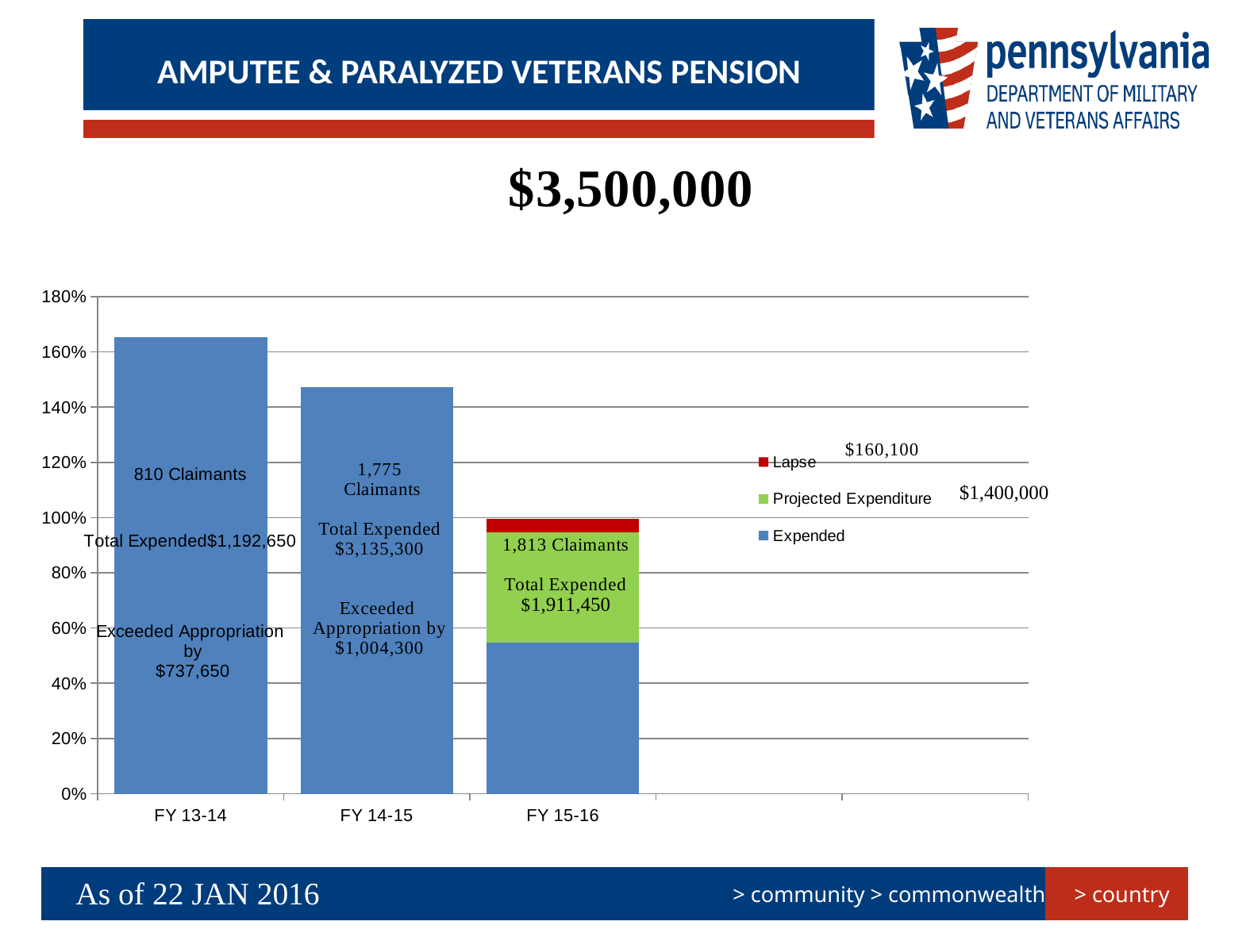
How many fiscal years are shown on the x axis of the chart? 3 What is the title shown above the chart? $3,500,000 How many claimants are labelled on the FY 13-14 bar? 810 Claimants What is the difference between the Total Expended amounts labelled for FY 14-15 and FY 13-14? $1,942,650 What kind of chart is shown on the slide? Stacked bar chart How many series does the chart's legend list? 3 Do the bar heights rise or fall from FY 13-14 to FY 15-16? fall Is the top of the FY 14-15 bar greater or less than 140%? greater Which fiscal year has the tallest bar in the chart? FY 13-14 What is the Total Expended amount labelled on the FY 15-16 bar? $1,911,450 What is the Total Expended amount labelled on the FY 14-15 bar? $3,135,300 By how much did FY 13-14 exceed its appropriation, according to the bar label? $737,650